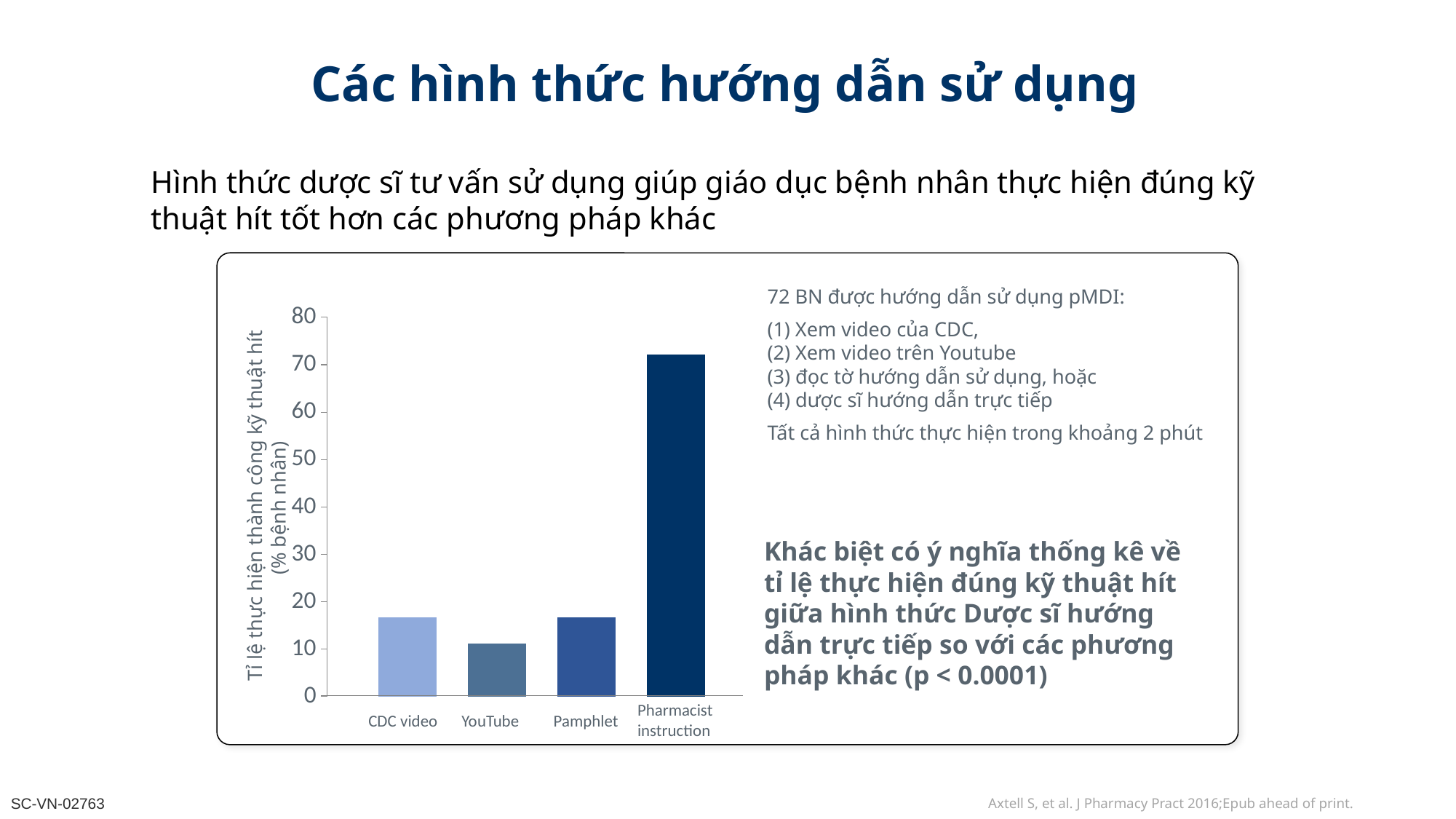
Which is larger, the value for Pharmacist instruction or the value for YouTube? Pharmacist instruction Is the value for Pharmacist instruction greater or less than 60? greater Is the value for Pamphlet greater or less than 30? less Which category has the lowest bar in the chart? YouTube Is the value for YouTube greater or less than 20? less How many categories are plotted on the x axis of the chart? 4 Which is larger, the value for Pamphlet or the value for YouTube? Pamphlet Which category has the highest bar in the chart? Pharmacist instruction What kind of chart is shown on the slide? bar chart What is the label of the fourth category on the x axis of the chart? Pharmacist instruction What is the highest tick value shown on the y axis of the chart? 80